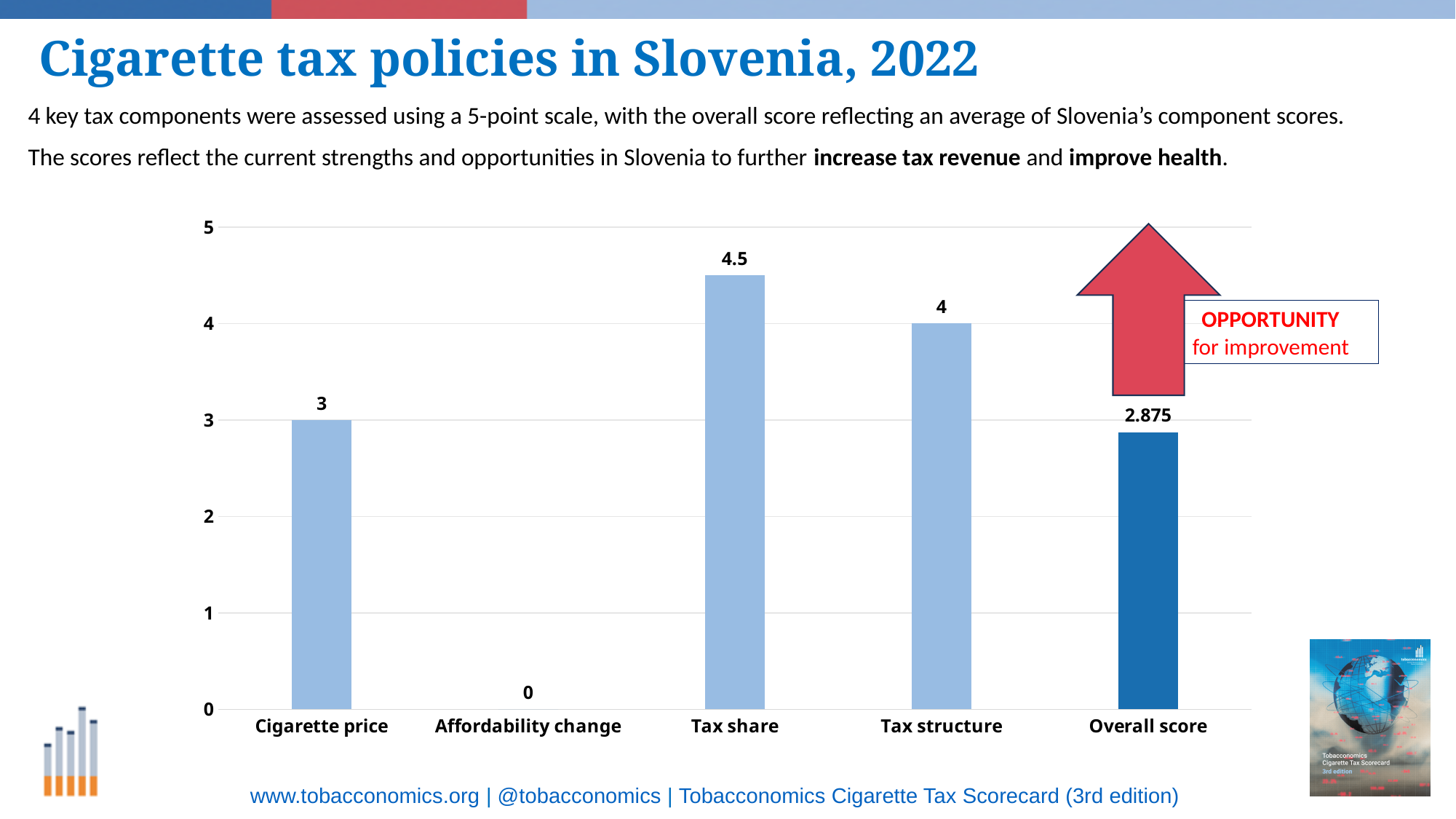
Which bar is shown in a darker blue than the others? Overall score Which is larger, the value for Cigarette price or the value for Tax structure? Tax structure What is the value for Tax share? 4.5 Which category has the highest value? Tax share What is the Overall score? 2.875 What kind of chart is shown on the slide? bar chart How many categories are shown on the x axis? 5 What is the difference between the values for Tax share and Tax structure? 0.5 Which category has the lowest value? Affordability change What is the value for Cigarette price? 3 Is the value for Overall score greater or less than 3? less What is the value for Affordability change? 0